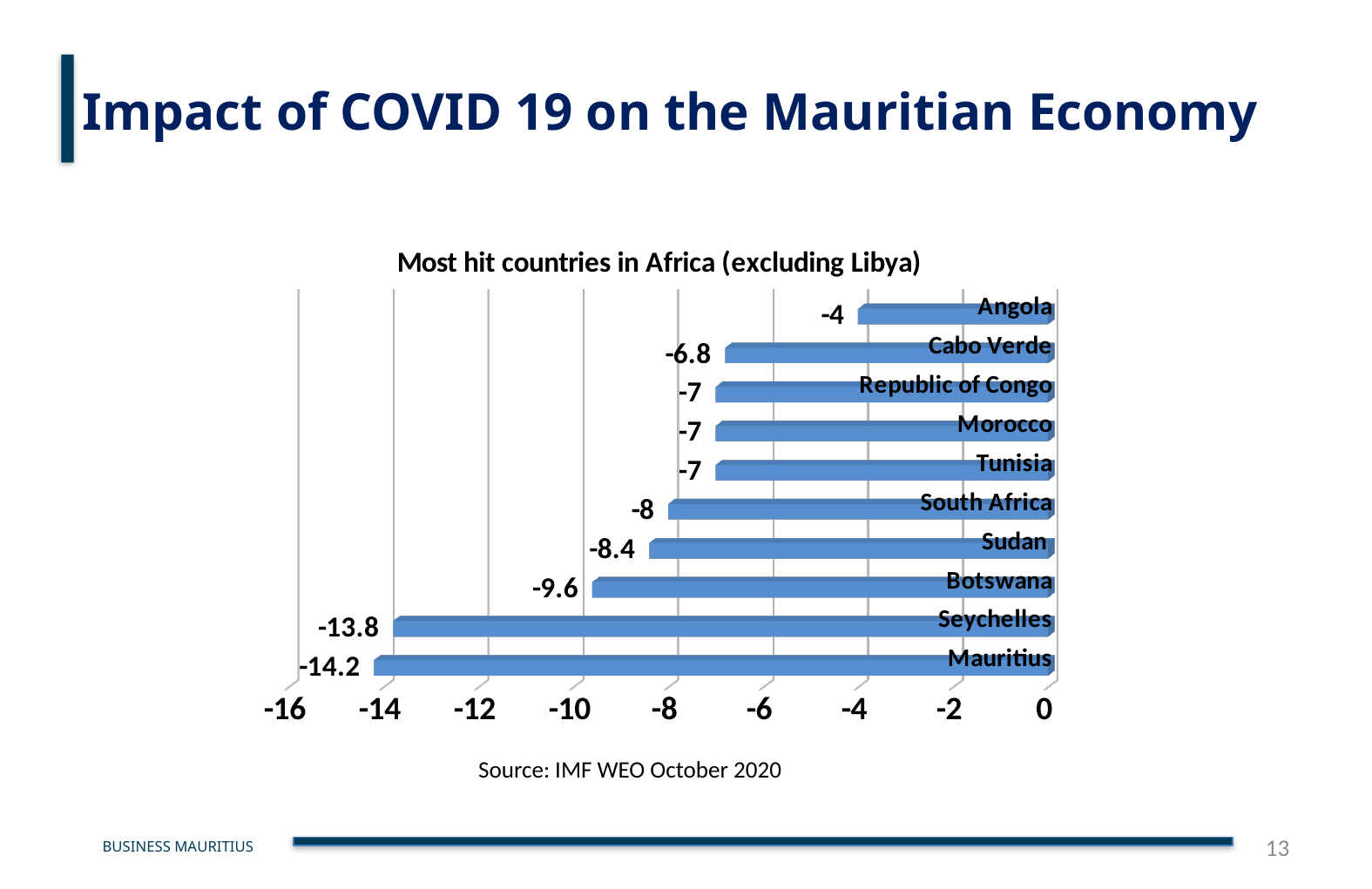
What is the value for Mauritius? -14.2 What is the value for Botswana? -9.6 What is the value for Seychelles? -13.8 What is the value for Angola? -4 Which country has the highest (least negative) value? Angola Which is more negative, the value for Botswana or the value for Sudan? Botswana How many countries are shown in the chart? 10 What kind of chart is shown on the slide? Bar chart What is the difference between the values for Mauritius and Seychelles? 0.4 What is the title of the chart? Most hit countries in Africa (excluding Libya) What is the difference between the values for Sudan and South Africa? 0.4 Which country has the lowest (most negative) value? Mauritius